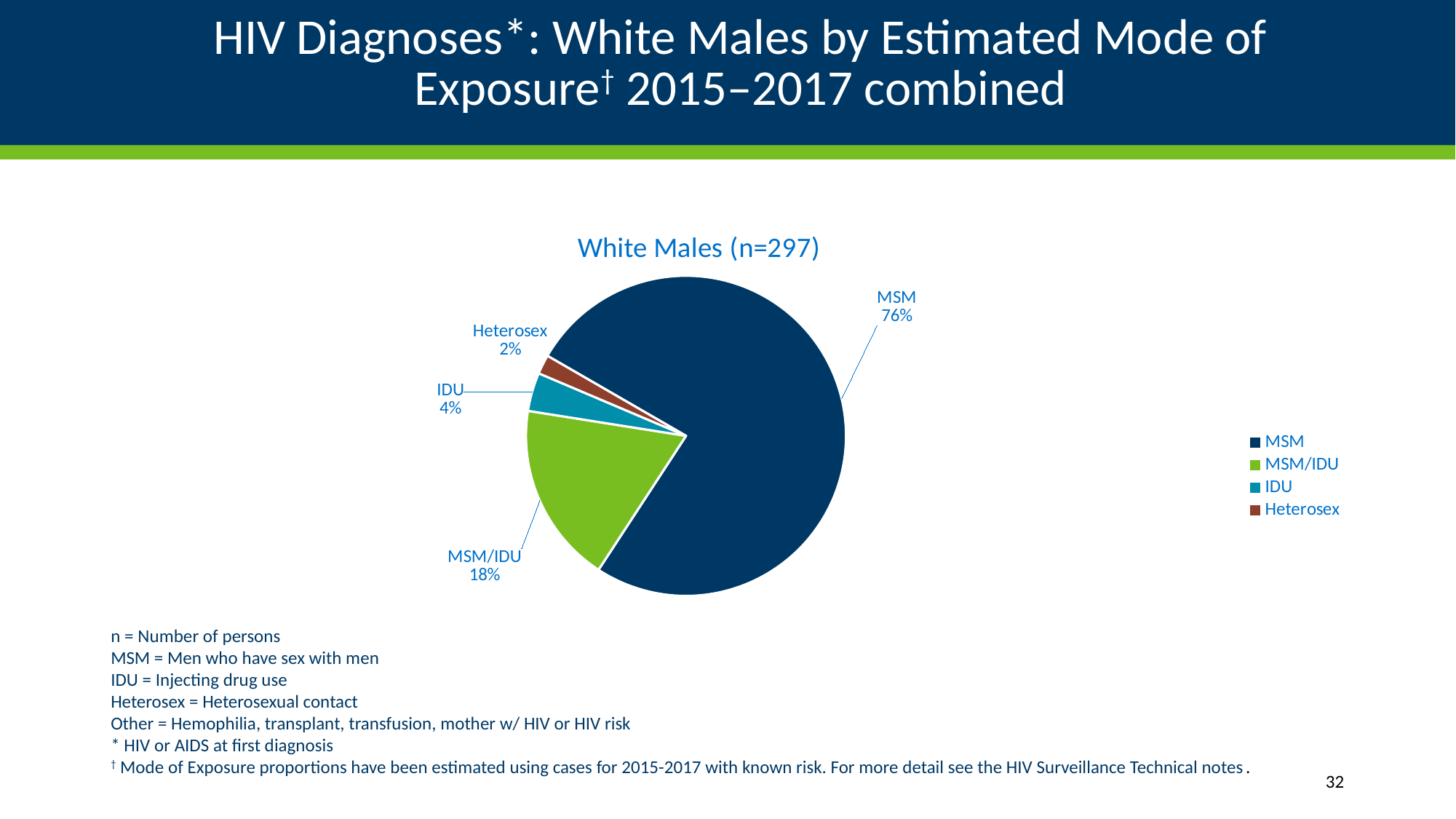
What is the difference in percentage points between MSM and MSM/IDU? 58 What percentage is shown for IDU? 4% What share of the pie does MSM account for? 76% Which is larger, the IDU slice or the Heterosex slice? IDU What percentage is shown for Heterosex? 2% What kind of chart is shown on the slide? Pie chart How many slices does the pie chart have? 4 Which mode of exposure has the smallest slice? Heterosex Which mode of exposure has the largest slice? MSM What is the title of the chart? White Males (n=297) How many entries does the legend list? 4 What percentage is shown for MSM/IDU? 18%